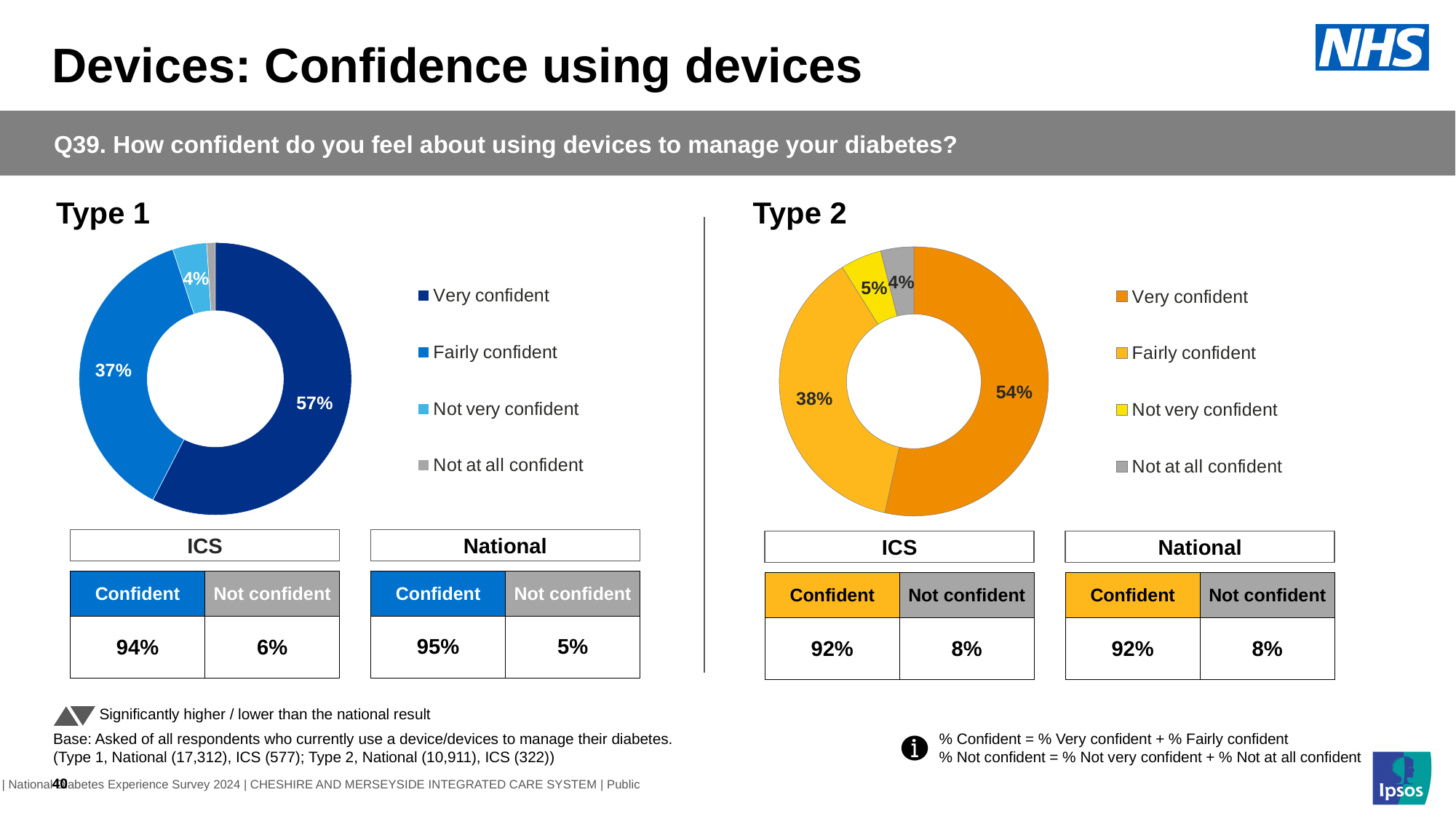
In the Type 1 chart, what percentage of respondents are not very confident? 4% In the Type 2 chart, what percentage of respondents are very confident? 54% What kind of chart is used for the Type 1 data? Donut chart In the Type 2 chart, what percentage of respondents are fairly confident? 38% In the Type 2 chart, which category has the largest share? Very confident In the Type 2 chart, what percentage of respondents are not at all confident? 4% In the Type 2 chart, which is larger: the share for fairly confident or the share for not very confident? Fairly confident In the Type 1 chart, what percentage of respondents are very confident? 57% In the Type 1 chart, what is the difference in percentage points between very confident and fairly confident? 20 How many categories does the legend of the Type 2 chart list? 4 In the Type 1 chart, what percentage of respondents are fairly confident? 37% In the Type 1 chart, which category has the smallest share? Not at all confident